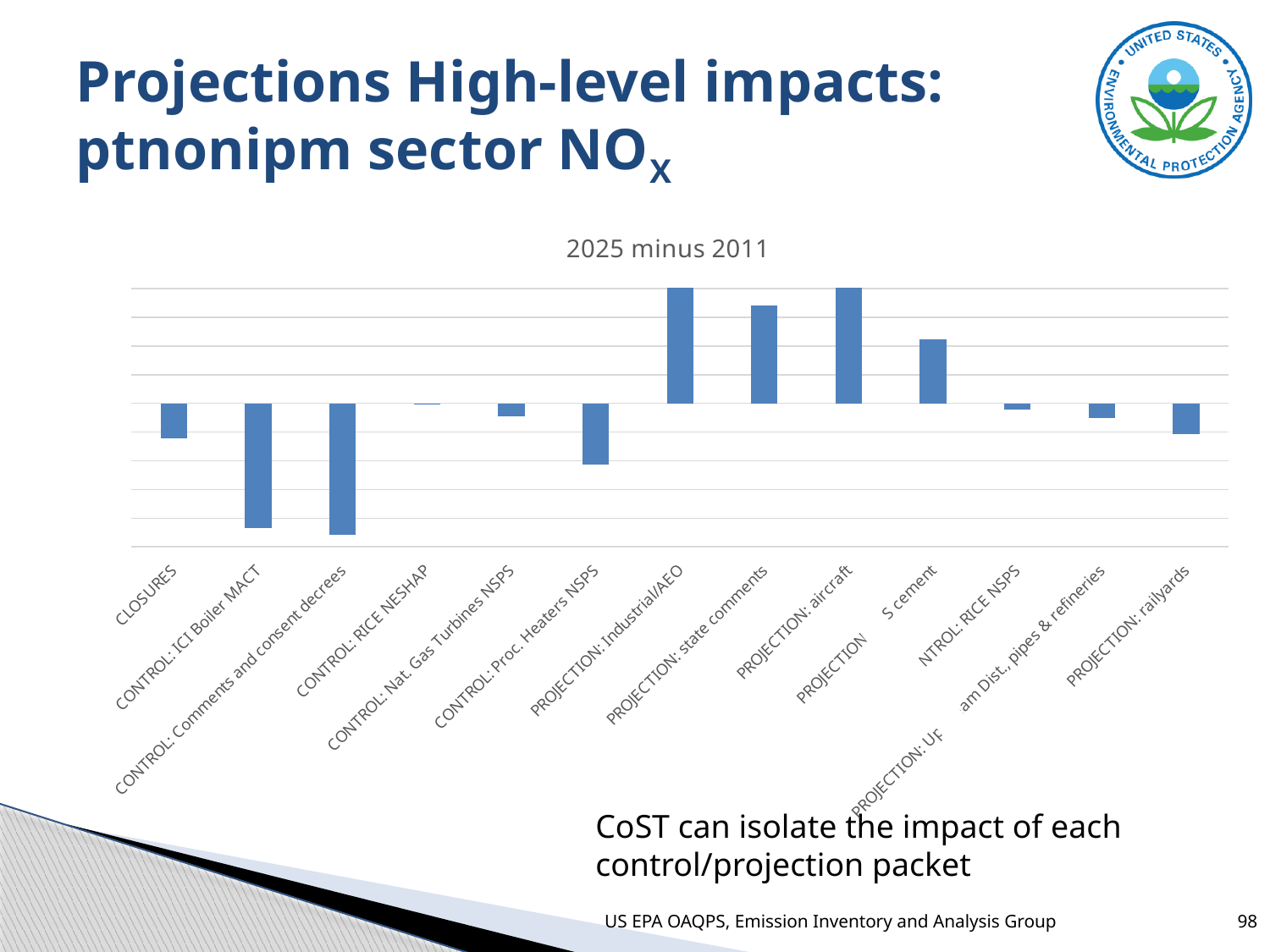
Which has the larger value, PROJECTION: Industrial/AEO or PROJECTION: railyards? PROJECTION: Industrial/AEO Is the value for CONTROL: Proc. Heaters NSPS greater or less than 0? less Which has the larger (more positive) value, CLOSURES or CONTROL: ICI Boiler MACT? CLOSURES Which has the larger value, PROJECTION: aircraft or PROJECTION: state comments? PROJECTION: aircraft Is the value for PROJECTION: state comments greater or less than 0? greater Is the value for PROJECTION: railyards greater or less than 0? less How many categories have a positive (above the baseline) value in the chart? 4 What colour are the bars in the chart? blue Which category has a bar closest to zero in the chart? CONTROL: RICE NESHAP What is the title of the chart? 2025 minus 2011 How many bars (categories) are plotted in the chart? 13 What type of chart is shown on the slide? bar chart